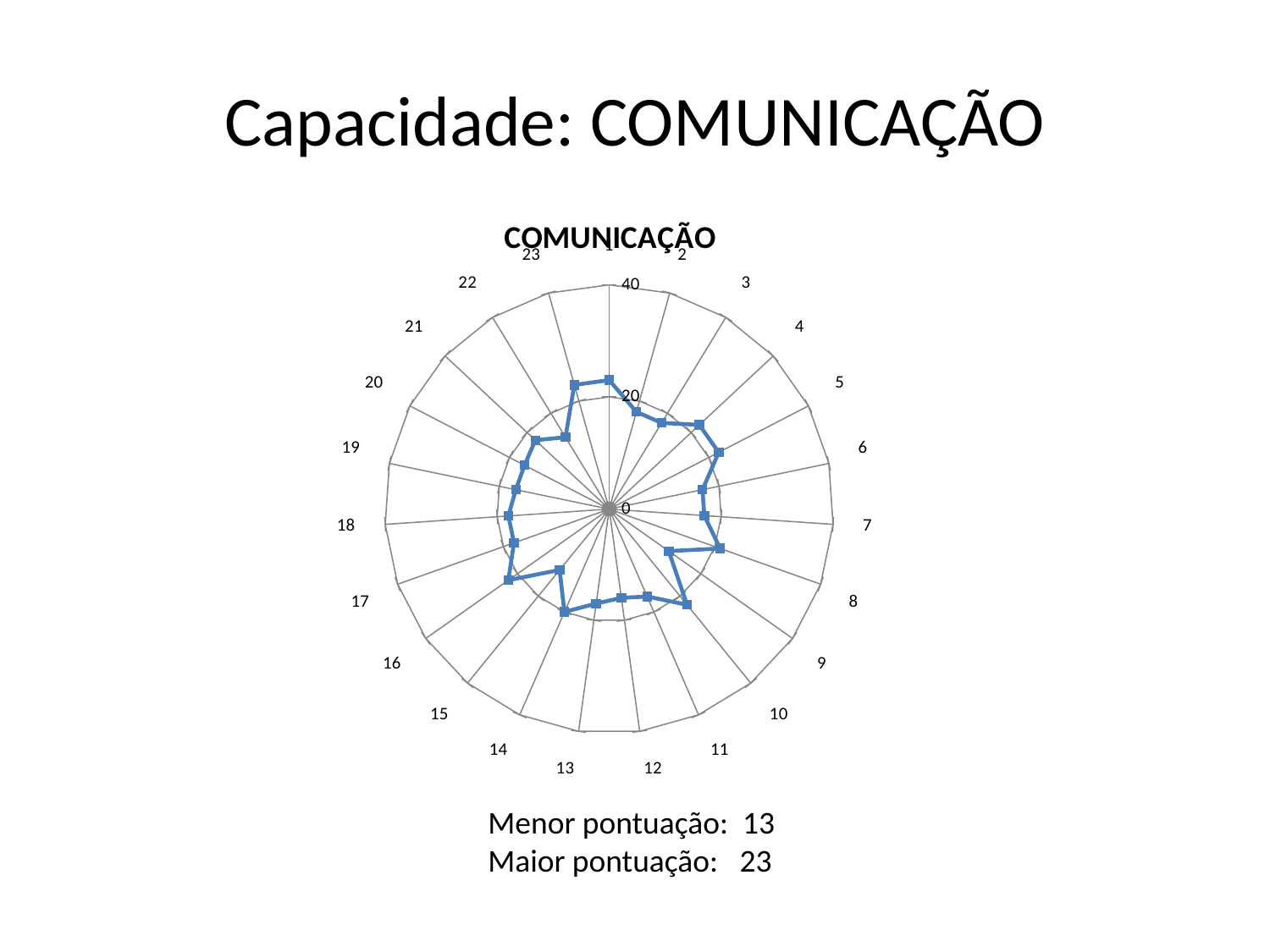
According to the text below the chart, what is the lowest score (Menor pontuação)? 13 What kind of chart is shown on the slide? radar chart Is the value for category 12 greater or less than 20? less Is the value for category 1 greater or less than 20? greater Is the value for category 7 greater or less than 20? less According to the text below the chart, what is the highest score (Maior pontuação)? 23 What is the maximum value shown on the chart's radial axis? 40 What is the title of the chart? COMUNICAÇÃO How many categories are plotted around the radar chart? 23